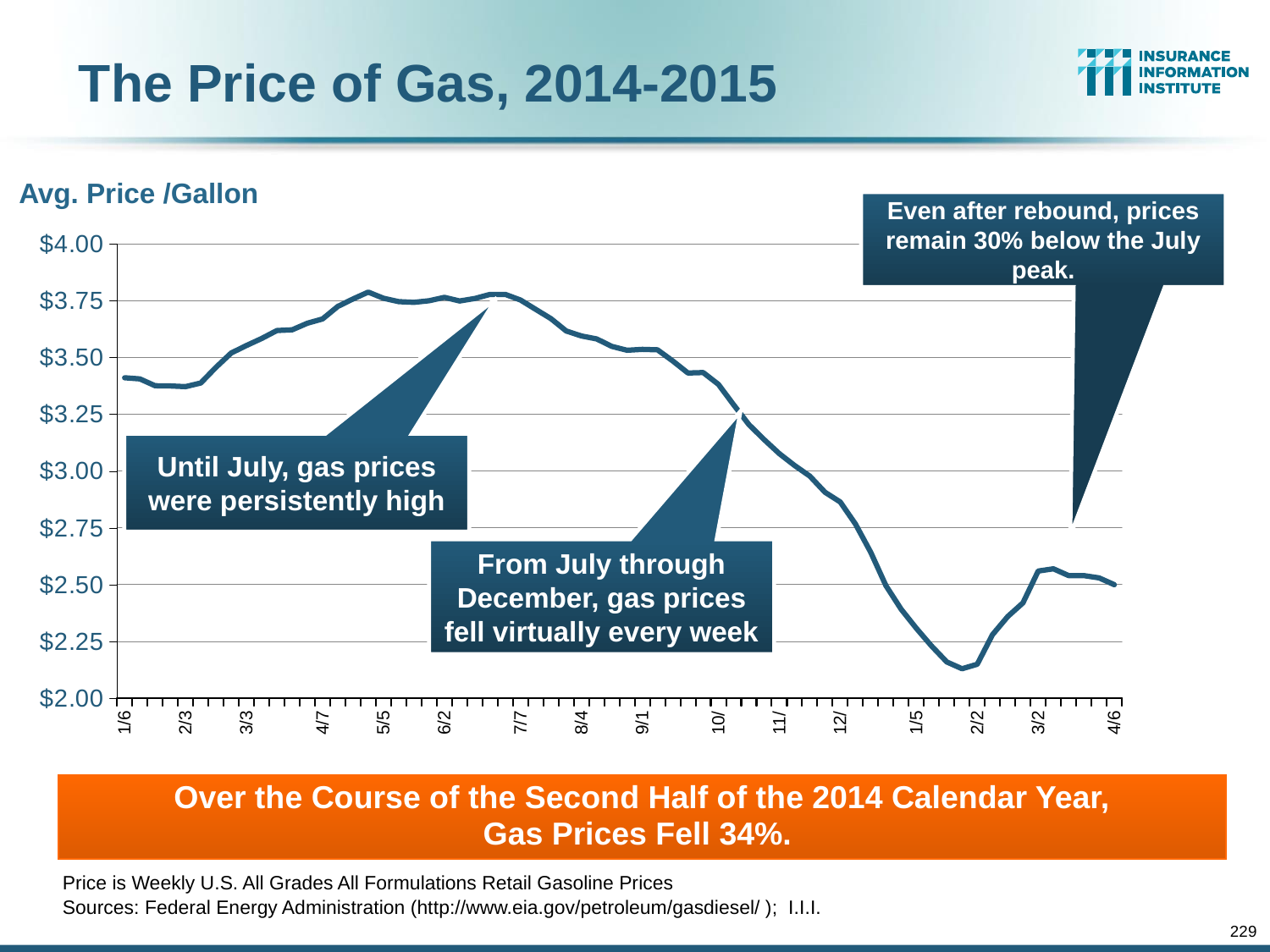
Is the value for 7/7 greater or less than $3.50? greater Do gas prices rise or fall between 1/6 and 5/5 on the chart? rise Is the value for 2/2 greater or less than $2.25? less What kind of chart is shown on the slide? line chart What is the title of the slide's chart? The Price of Gas, 2014-2015 Which is larger, the value for 1/6 or the value for 1/5? 1/6 Is the value for 12/ greater or less than $3.00? less Do gas prices rise or fall between 7/7 and 12/ on the chart? fall What label is given to the vertical axis of the chart? Avg. Price /Gallon How many date labels are shown along the x axis of the chart? 16